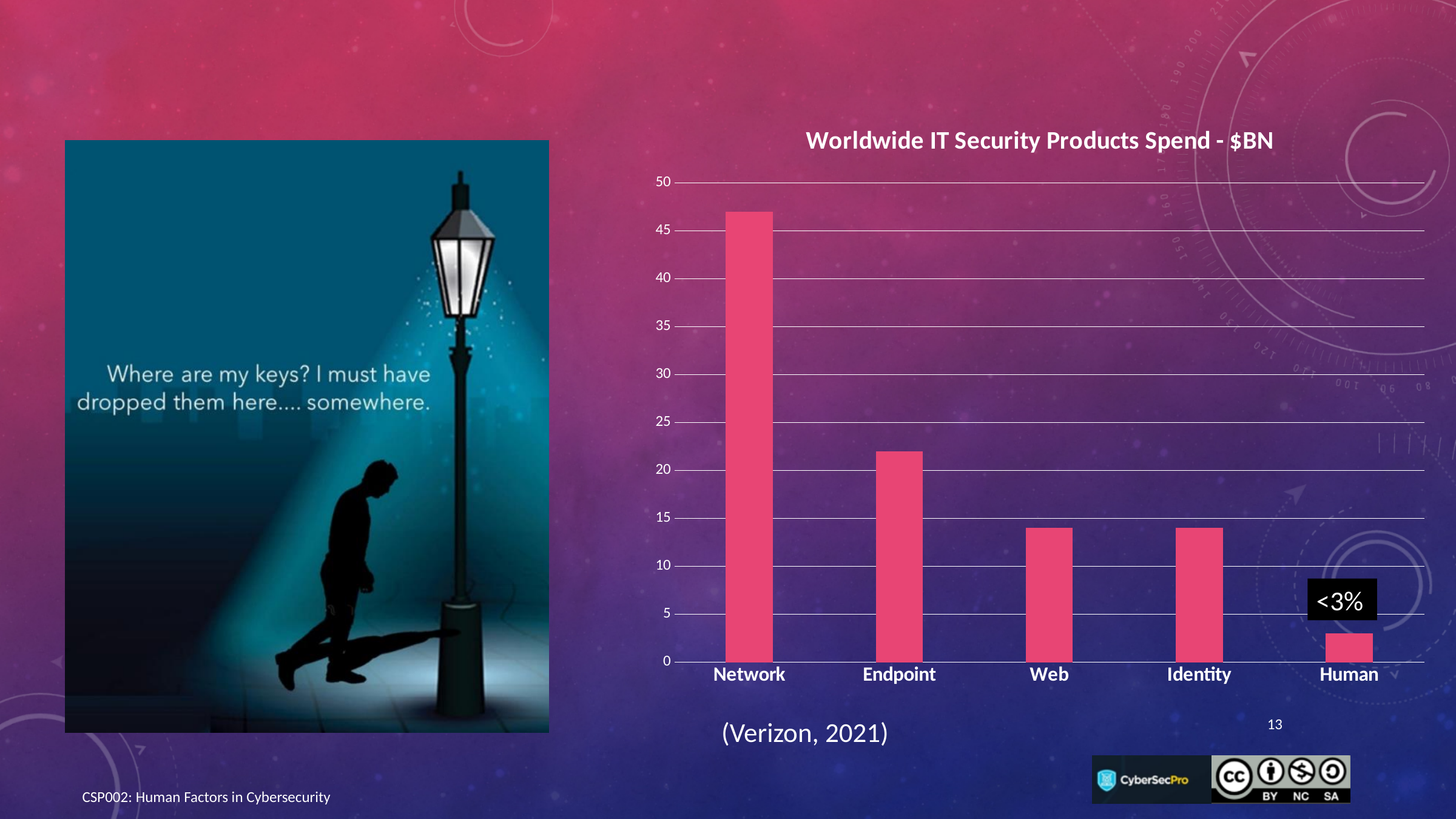
What is the title of the chart? Worldwide IT Security Products Spend - $BN Is the value for Endpoint greater or less than 20? greater Which category has the lowest spend in the chart? Human What type of chart is shown on the slide? bar chart How many categories are shown on the x axis of the chart? 5 Is the value for Network greater or less than 45? greater What label is printed above the Human bar in the chart? <3% Which category has the highest spend in the chart? Network Do the values generally rise or fall moving from Network to Human along the x axis? fall Which has a larger spend, Network or Endpoint? Network Is the value for Web greater or less than 15? less